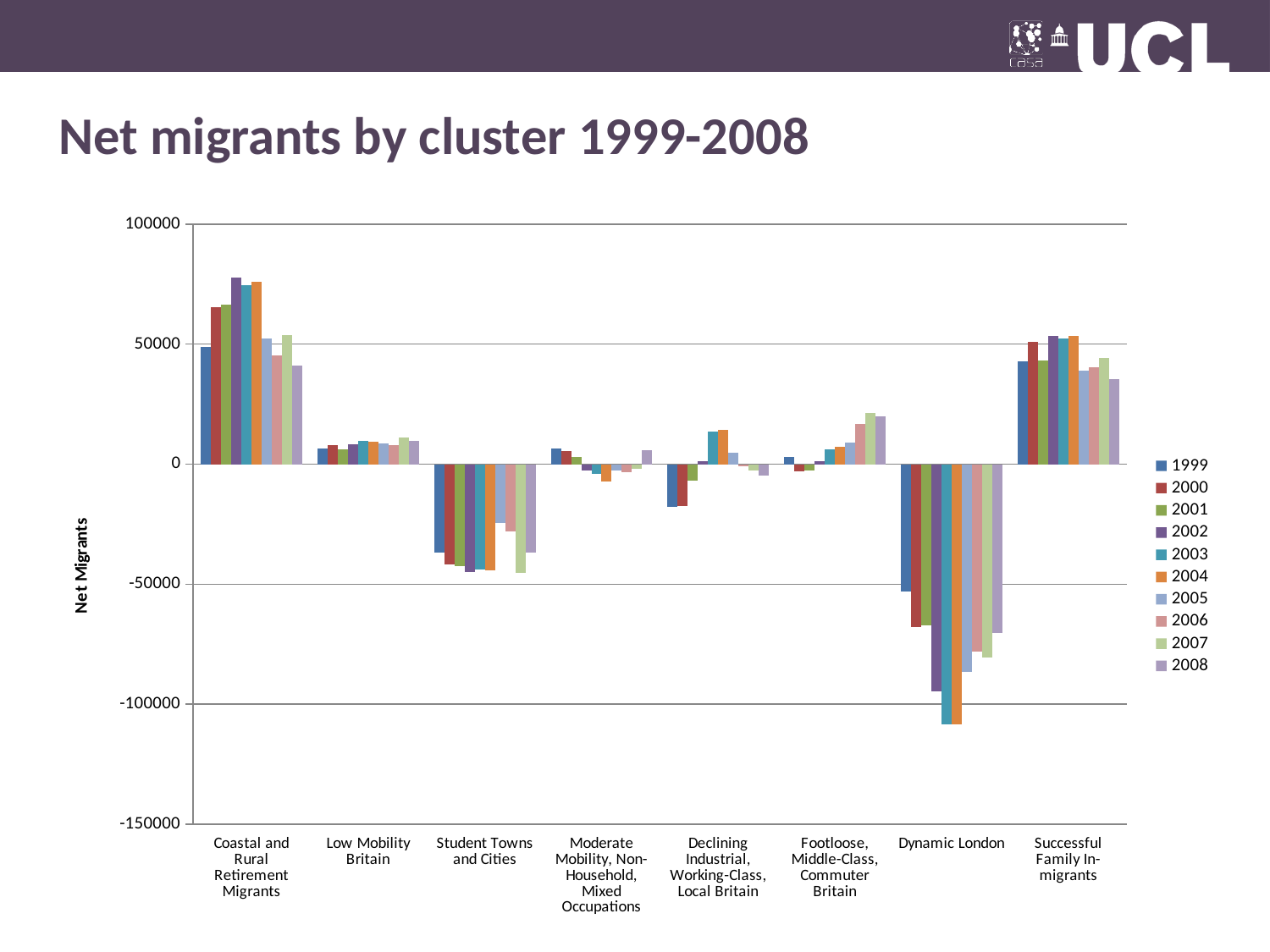
Is the value for Successful Family In-migrants in 2008 greater or less than 50000? less How many clusters are shown along the x axis? 8 What kind of chart is shown on the slide? bar chart For Successful Family In-migrants, which year has the larger value, 2002 or 2008? 2002 What is the title of the chart? Net migrants by cluster 1999-2008 Is the value for Coastal and Rural Retirement Migrants in 2002 greater or less than 50000? greater Is the value for Dynamic London in 2003 greater or less than -100000? less How many series does the legend list? 10 Which cluster has the most negative net migrant values? Dynamic London What is the label on the vertical axis? Net Migrants Which cluster has the highest net migrant values? Coastal and Rural Retirement Migrants Do the values for Dynamic London rise or fall from 1999 to 2004? fall